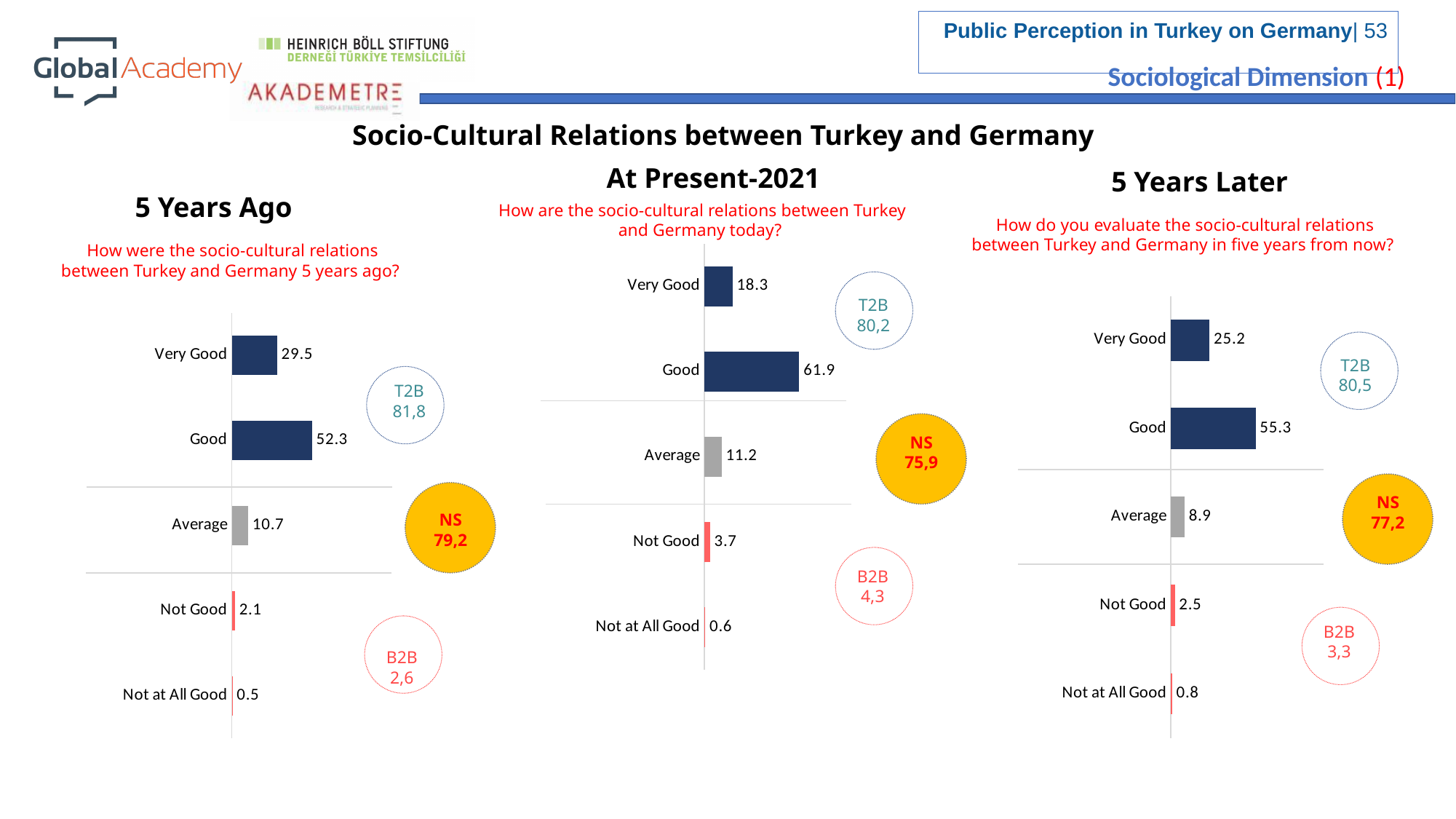
In the 'At Present-2021' chart, what is the difference between Average and Not Good? 7.5 How many categories does the '5 Years Ago' chart show? 5 In the '5 Years Later' chart, what is the value for Average? 8.9 In the '5 Years Later' chart, which is larger, Not Good or Not at All Good? Not Good In the '5 Years Ago' chart, what is the value for Good? 52.3 In the 'At Present-2021' chart, what is the value for Very Good? 18.3 What T2B value is shown next to the '5 Years Later' chart? 80,5 In the '5 Years Ago' chart, what is the difference between Good and Very Good? 22.8 Is the value for Very Good larger in the '5 Years Ago' chart or in the '5 Years Later' chart? 5 Years Ago In the 'At Present-2021' chart, which category has the highest value? Good What kind of chart is the 'At Present-2021' chart? Bar chart In the '5 Years Later' chart, which category has the lowest value? Not at All Good